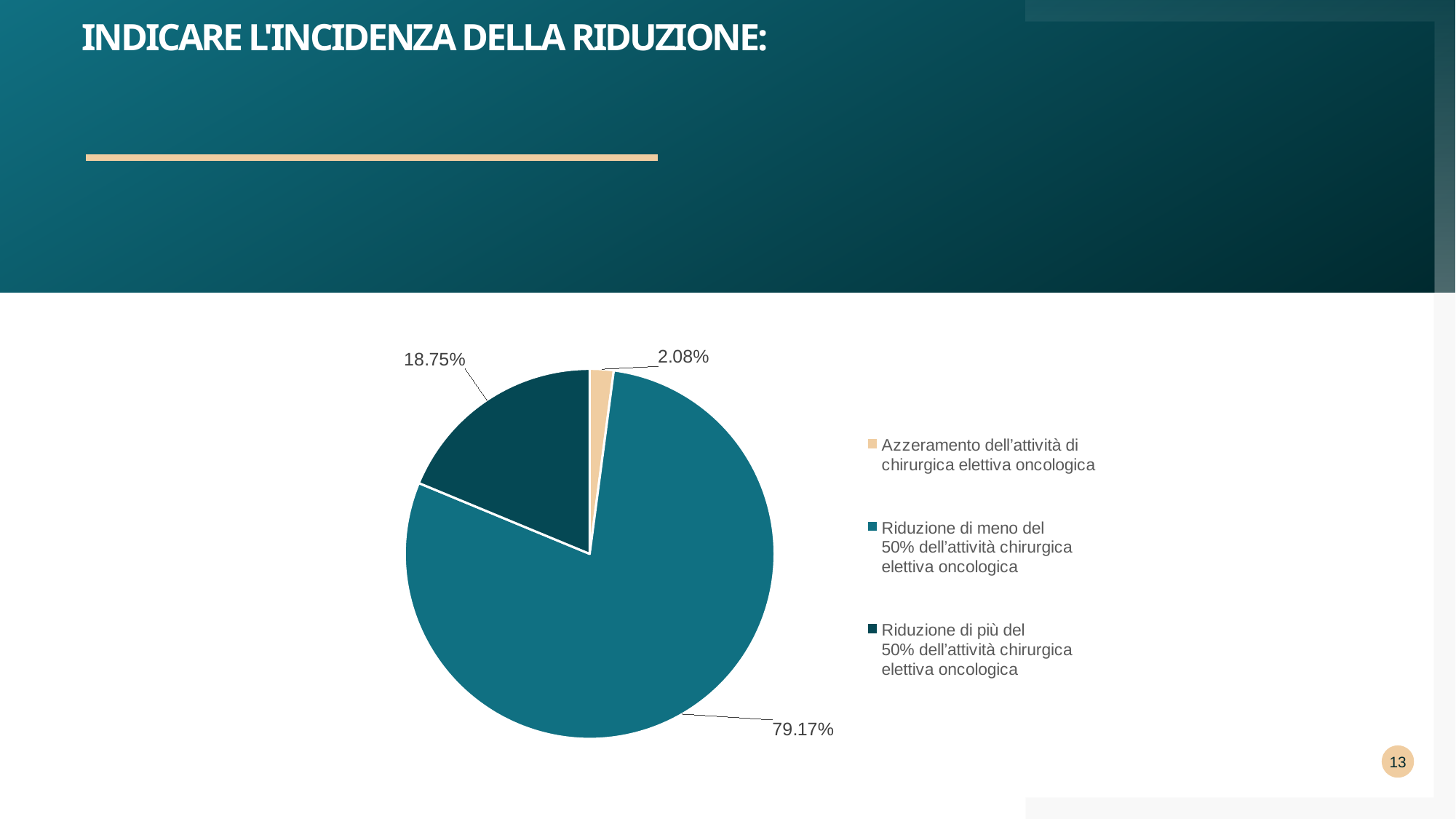
What kind of chart is shown on the slide? Pie chart Which is larger: the 'Riduzione di più del 50%' slice or the 'Azzeramento' slice? Riduzione di più del 50% dell'attività chirurgica elettiva oncologica Which category has the smallest slice of the pie? Azzeramento dell'attività di chirurgica elettiva oncologica What share of the pie is 'Azzeramento dell'attività di chirurgica elettiva oncologica'? 2.08% What is the difference in percentage points between the 'Riduzione di più del 50%' slice and the 'Azzeramento' slice? 16.67 What share of the pie is 'Riduzione di più del 50% dell'attività chirurgica elettiva oncologica'? 18.75% Which category has the largest slice of the pie? Riduzione di meno del 50% dell'attività chirurgica elettiva oncologica What is the difference in percentage points between the 'Riduzione di meno del 50%' slice and the 'Riduzione di più del 50%' slice? 60.42 What is the title of the slide containing the chart? INDICARE L'INCIDENZA DELLA RIDUZIONE: How many categories does the pie chart have? 3 What share of the pie is 'Riduzione di meno del 50% dell'attività chirurgica elettiva oncologica'? 79.17% What colour is the slice for 'Azzeramento dell'attività di chirurgica elettiva oncologica'? Beige